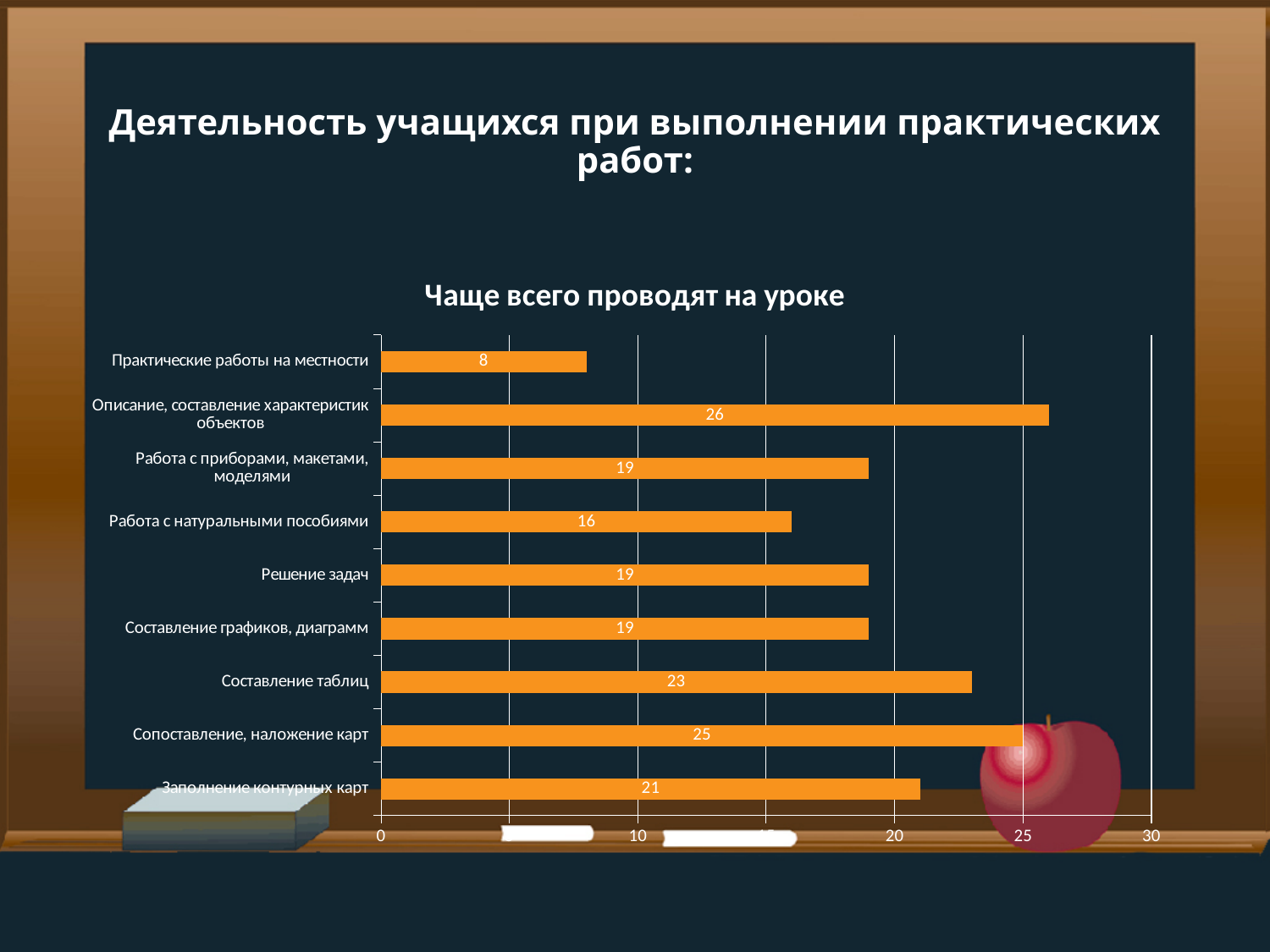
What is the value for "Сопоставление, наложение карт"? 25 Is the value for "Сопоставление, наложение карт" greater or less than 20? greater What is the difference between the values for "Описание, составление характеристик объектов" and "Заполнение контурных карт"? 5 Which category has the highest value? Описание, составление характеристик объектов How many categories are shown in the chart? 9 Which is larger: the value for "Составление таблиц" or the value for "Решение задач"? Составление таблиц What is the value for "Работа с натуральными пособиями"? 16 What is the value for "Составление таблиц"? 23 What is the value for "Практические работы на местности"? 8 What is the title of the chart? Чаще всего проводят на уроке Which category has the lowest value? Практические работы на местности What kind of chart is shown on the slide? Bar chart